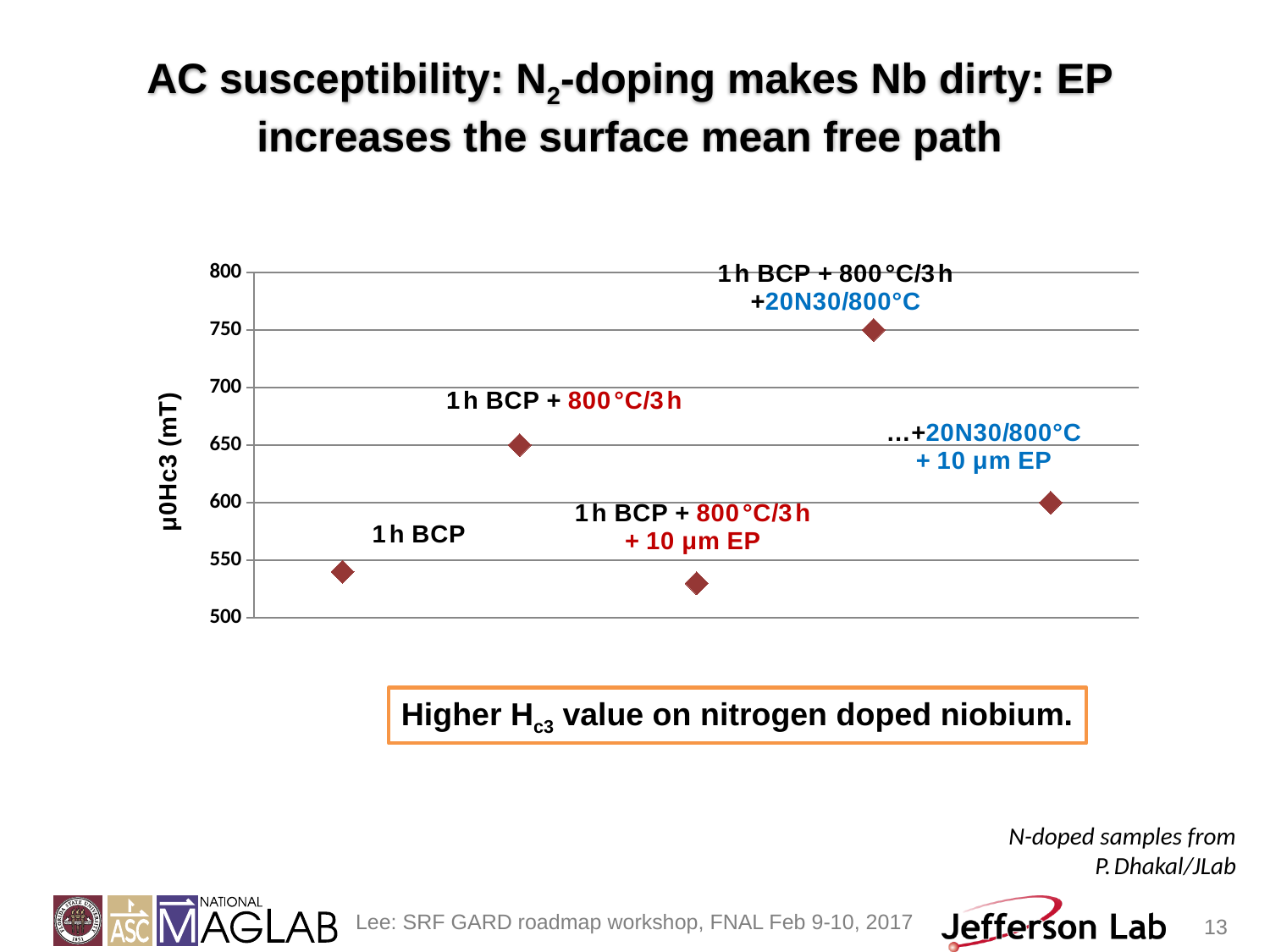
What is the label of the vertical axis? µ0Hc3 (mT) Which sample has the lowest µ0Hc3 value? 1h BCP + 800°C/3h + 10 µm EP Is the µ0Hc3 value for the 1h BCP sample greater or less than 550? less What is the difference in µ0Hc3 between the 1h BCP + 800°C/3h + 20N30/800°C sample and the ...+20N30/800°C + 10 µm EP sample? 150 mT How many data points are plotted on the chart? 5 What is the µ0Hc3 value for the 1h BCP + 800°C/3h sample? 650 mT What is the difference in µ0Hc3 between the 1h BCP + 800°C/3h + 20N30/800°C sample and the 1h BCP + 800°C/3h sample? 100 mT What kind of chart is shown on the slide? scatter chart What is the µ0Hc3 value for the ...+20N30/800°C + 10 µm EP sample? 600 mT Which has a larger µ0Hc3 value: the 1h BCP + 800°C/3h sample or the ...+20N30/800°C + 10 µm EP sample? 1h BCP + 800°C/3h What is the µ0Hc3 value for the 1h BCP + 800°C/3h + 20N30/800°C sample? 750 mT Which sample has the highest µ0Hc3 value? 1h BCP + 800°C/3h + 20N30/800°C